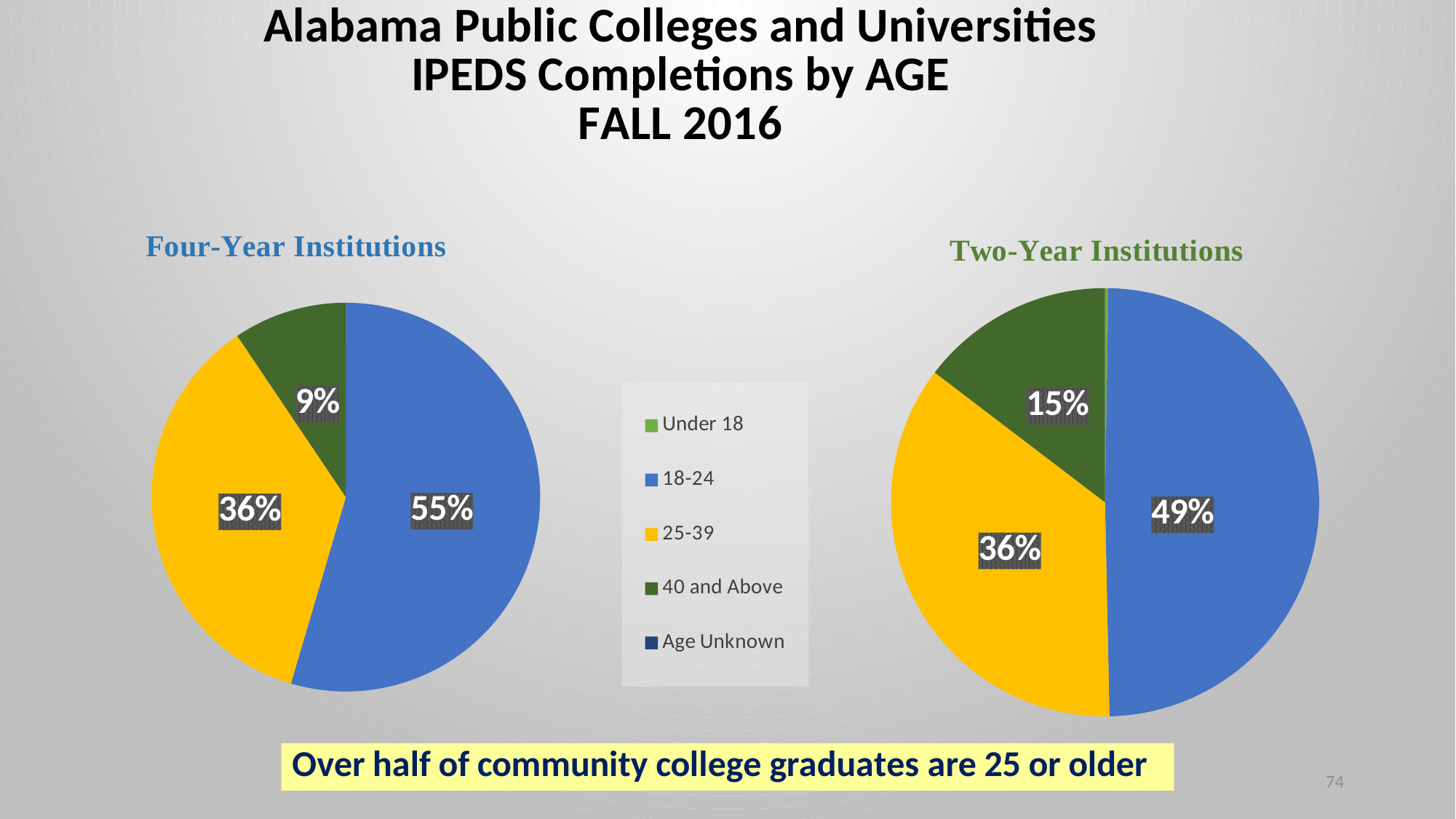
In the Two-Year Institutions pie chart, what share of completions is for the 40 and Above age group? 15% In the Four-Year Institutions pie chart, what share of completions is for the 25-39 age group? 36% In the Two-Year Institutions pie chart, which labelled age group has the largest share? 18-24 What is the difference in percentage points between the 18-24 share in the Four-Year Institutions chart and the 18-24 share in the Two-Year Institutions chart? 6 Which chart shows a larger share for the 40 and Above age group, Four-Year Institutions or Two-Year Institutions? Two-Year Institutions In the Four-Year Institutions pie chart, what share of completions is for the 18-24 age group? 55% How many age groups does the legend list? 5 In the Four-Year Institutions pie chart, which labelled age group has the largest share? 18-24 What type of chart is used for the Four-Year Institutions data? Pie chart In the Four-Year Institutions pie chart, which labelled age group has the smallest share? 40 and Above What colour represents the 25-39 age group in the legend? Yellow In the Two-Year Institutions pie chart, what share of completions is for the 18-24 age group? 49%